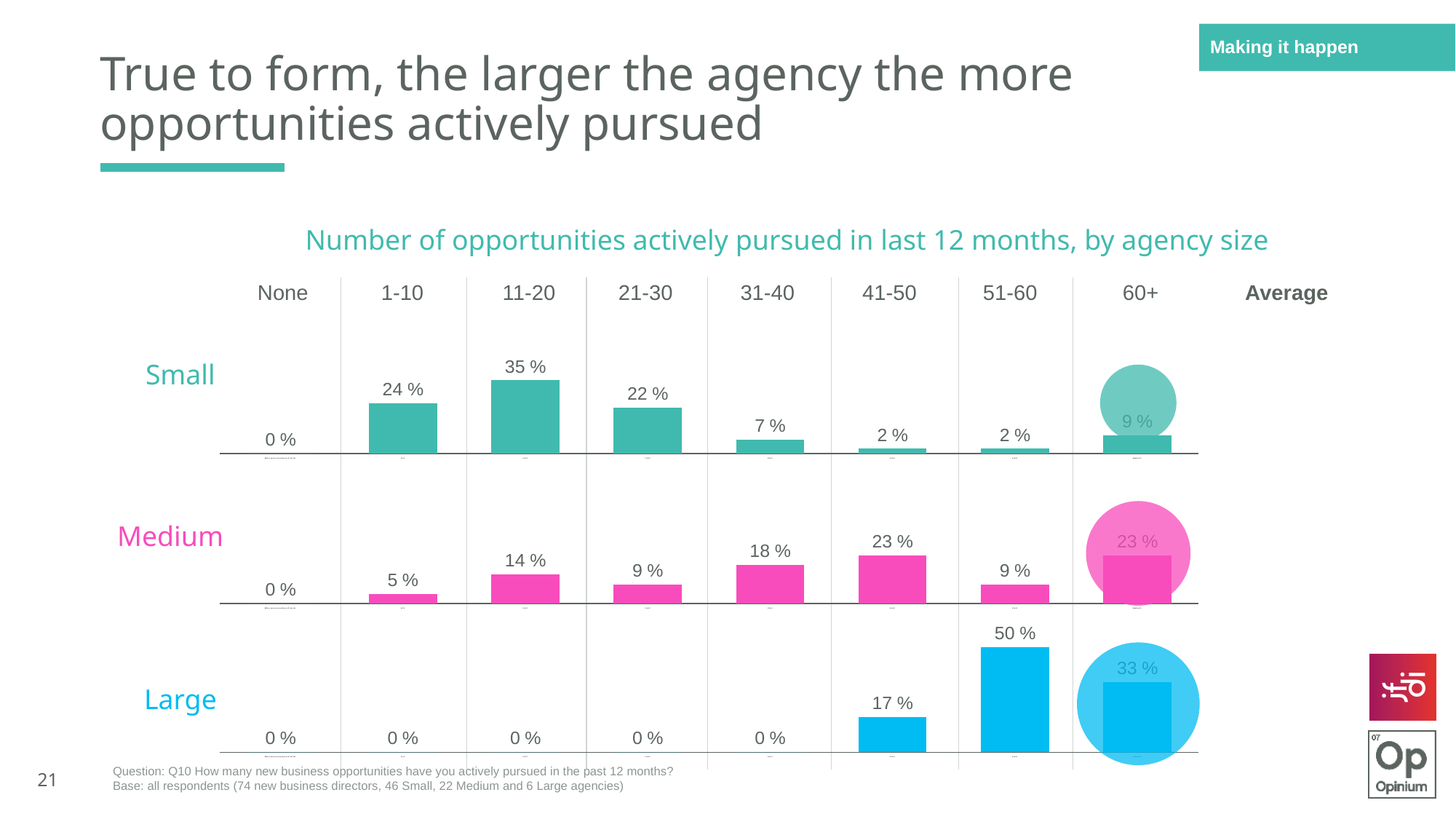
In the Medium agencies chart, what is the value for 41-50 opportunities? 23 % How many categories of opportunity counts are shown along the top of the charts, excluding Average? 8 In the Large agencies chart, what is the value for 51-60 opportunities? 50 % In the Large agencies chart, which category has the highest value? 51-60 In the Small agencies chart, what is the value for 11-20 opportunities? 35 % In the Large agencies chart, what is the value for 41-50 opportunities? 17 % In the Small agencies chart, which is larger, the value for 1-10 or the value for 21-30? 1-10 In the Medium agencies chart, what is the difference between the values for 31-40 and 1-10? 13 % What is the title of the chart on the slide? Number of opportunities actively pursued in last 12 months, by agency size In the Large agencies chart, how many categories have a value of 0 %? 5 What kind of chart is used for the Small, Medium and Large agency rows? Bar chart In the Small agencies chart, which category has the highest value? 11-20